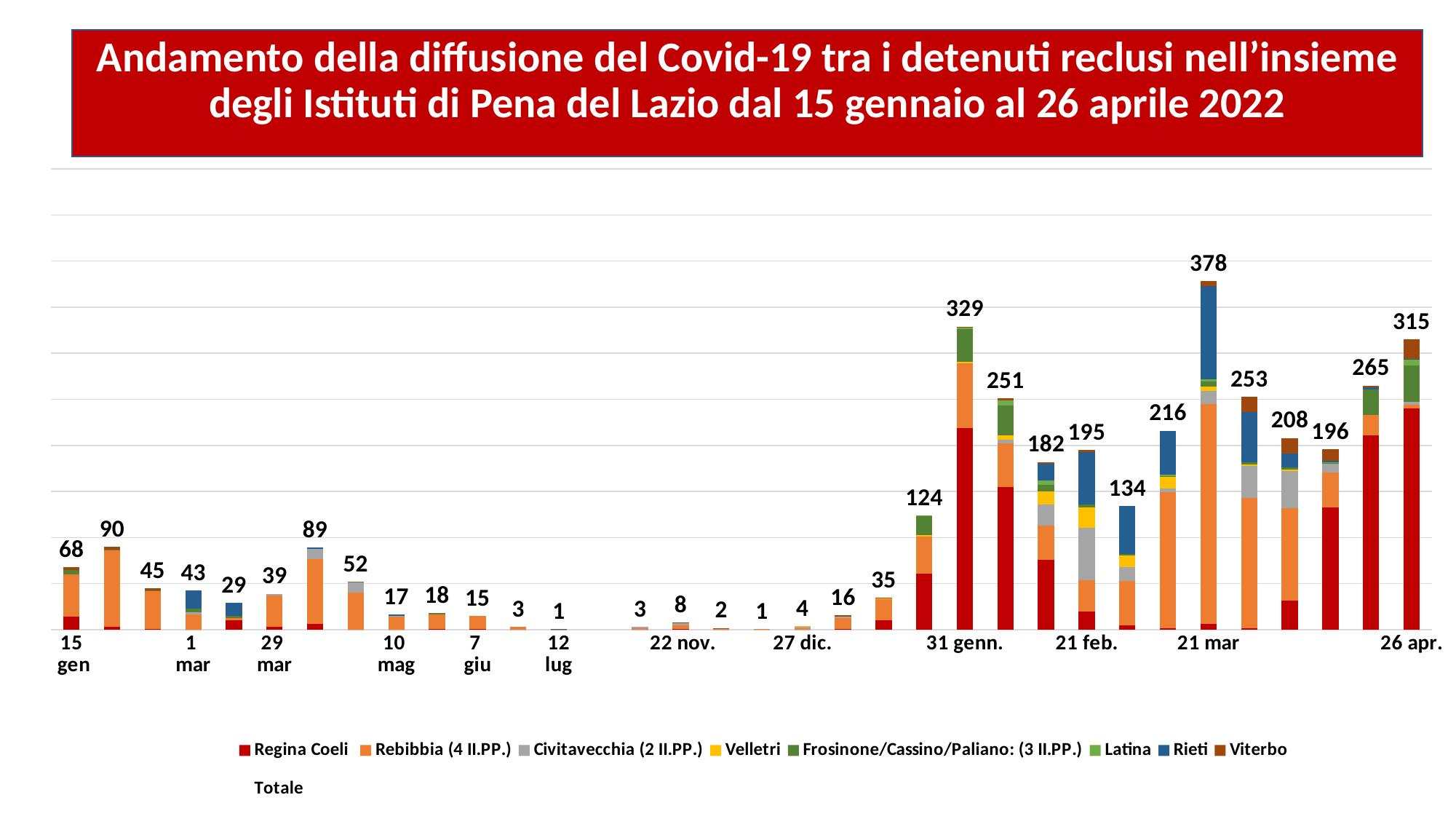
How many bars are plotted on the chart? 33 What colour represents Regina Coeli in the legend? Red Which has a larger total, 31 genn. or 21 feb.? 31 genn. What is the total value shown for the bar labelled 26 apr.? 315 What is the total value shown for the bar labelled 15 gen? 68 What kind of chart is shown on the slide? Stacked bar chart What is the total value shown for the bar labelled 21 feb.? 195 Which date has the highest total on the chart? 21 mar What is the difference between the totals for 21 mar and 26 apr.? 63 What is the total value shown for the bar labelled 21 mar? 378 What is the total value shown for the bar labelled 31 genn.? 329 How many series does the legend list? 9